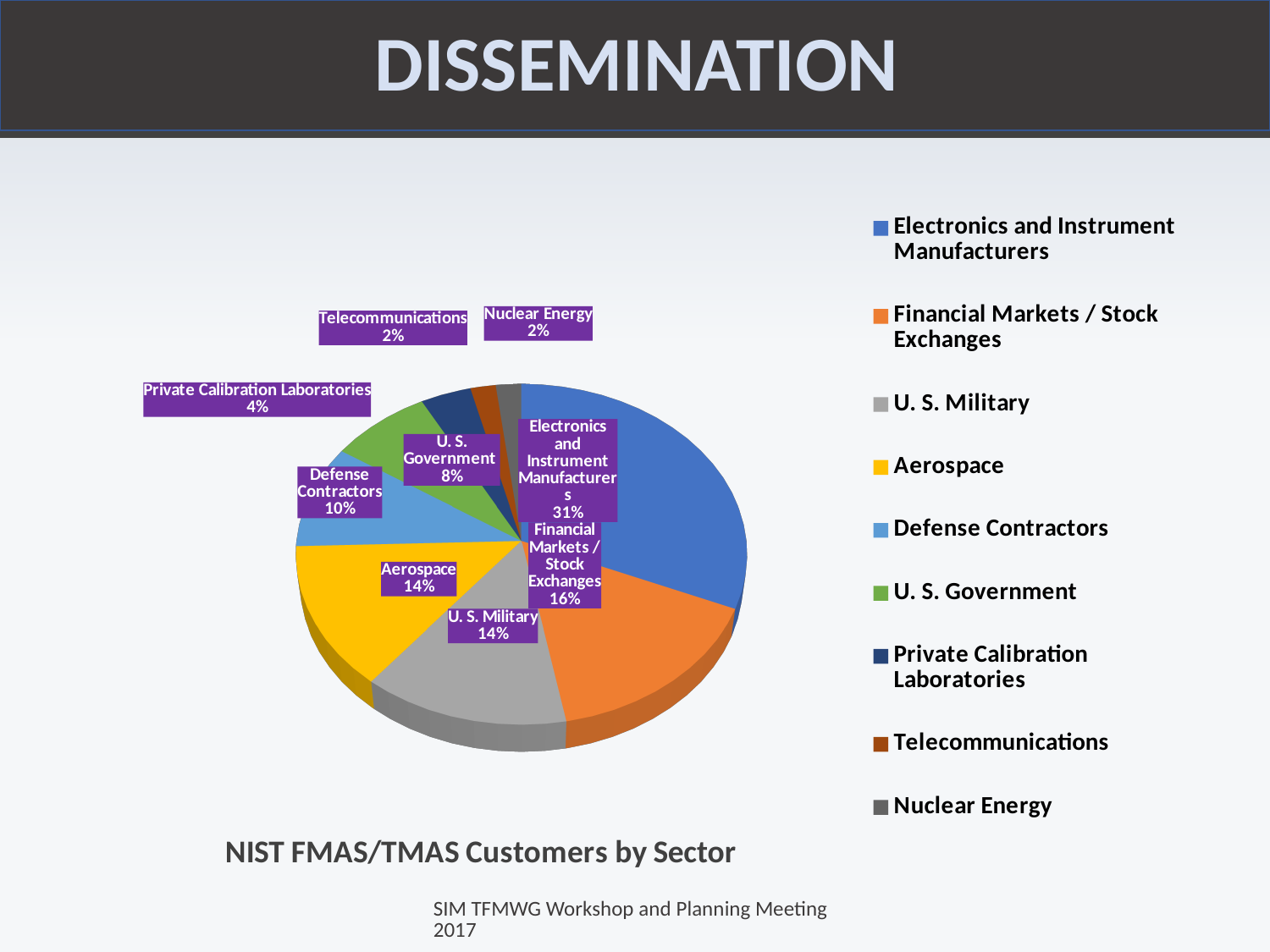
Which sector has the largest share of the pie? Electronics and Instrument Manufacturers What percentage is shown for U. S. Government? 8% What is the value shown for Financial Markets / Stock Exchanges? 16% Which is larger, the share for Defense Contractors or the share for U. S. Government? Defense Contractors What share of the pie does Electronics and Instrument Manufacturers hold? 31% What percentage is shown for Private Calibration Laboratories? 4% What type of chart is shown on the slide? Pie chart What is the difference in percentage points between Aerospace and Private Calibration Laboratories? 10 percentage points What is the difference in percentage points between Electronics and Instrument Manufacturers and Financial Markets / Stock Exchanges? 15 percentage points What percentage is shown for Defense Contractors? 10% What is the title of the chart? NIST FMAS/TMAS Customers by Sector How many sectors are shown in the pie chart? 9